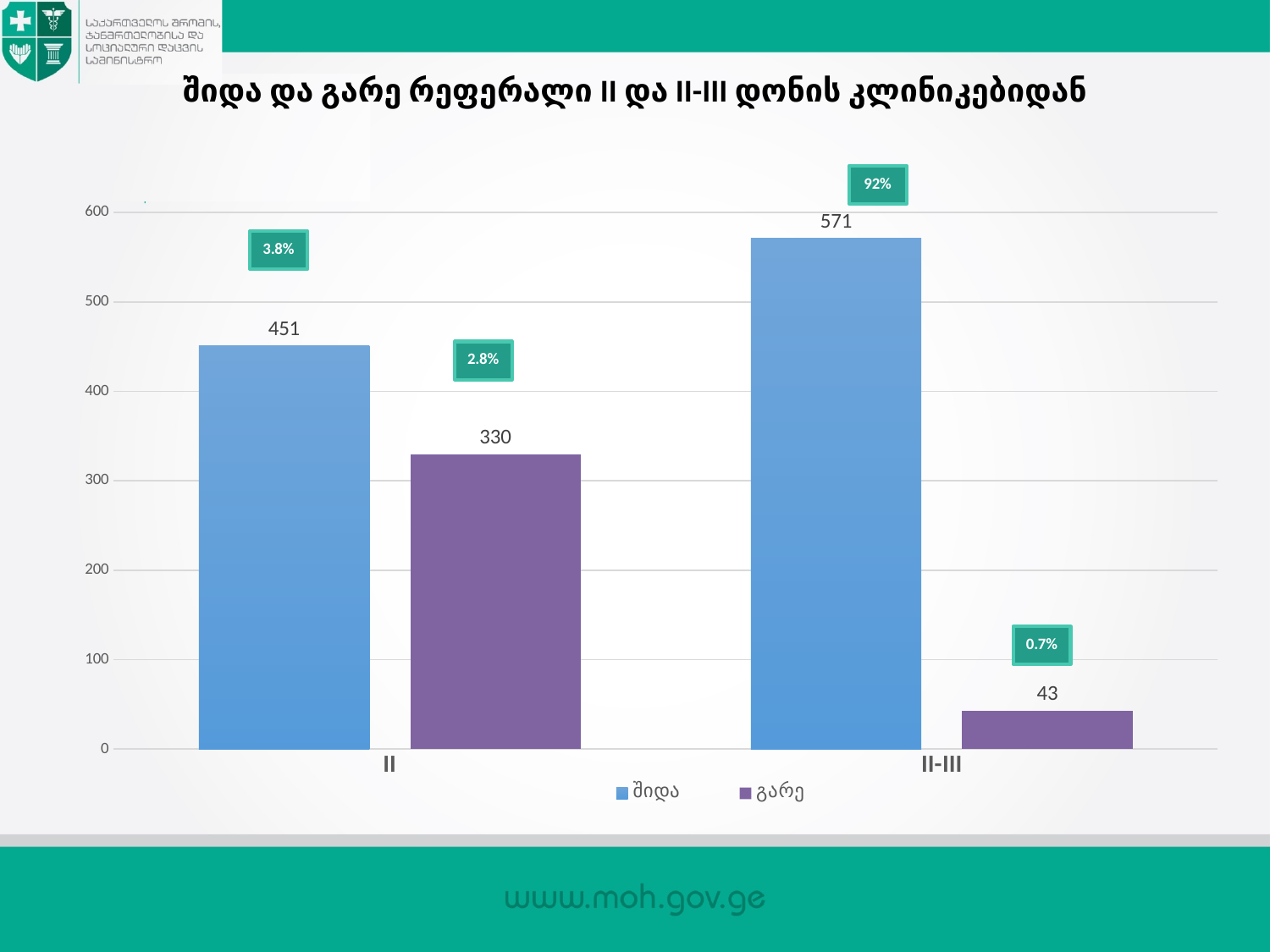
How many series does the legend list? 2 What is the value of გარე for category II? 330 What is the value of შიდა for category II? 451 Which bar has the highest value on the chart? შიდა for II-III What is the value of გარე for category II-III? 43 What is the value of შიდა for category II-III? 571 Which is larger for category II, შიდა or გარე? შიდა What is the difference between შიდა for II-III and შიდა for II? 120 Which bar has the lowest value on the chart? გარე for II-III What is the difference between შიდა and გარე for category II-III? 528 What percentage label is shown above the გარე bar for category II-III? 0.7% What kind of chart is shown on the slide? bar chart